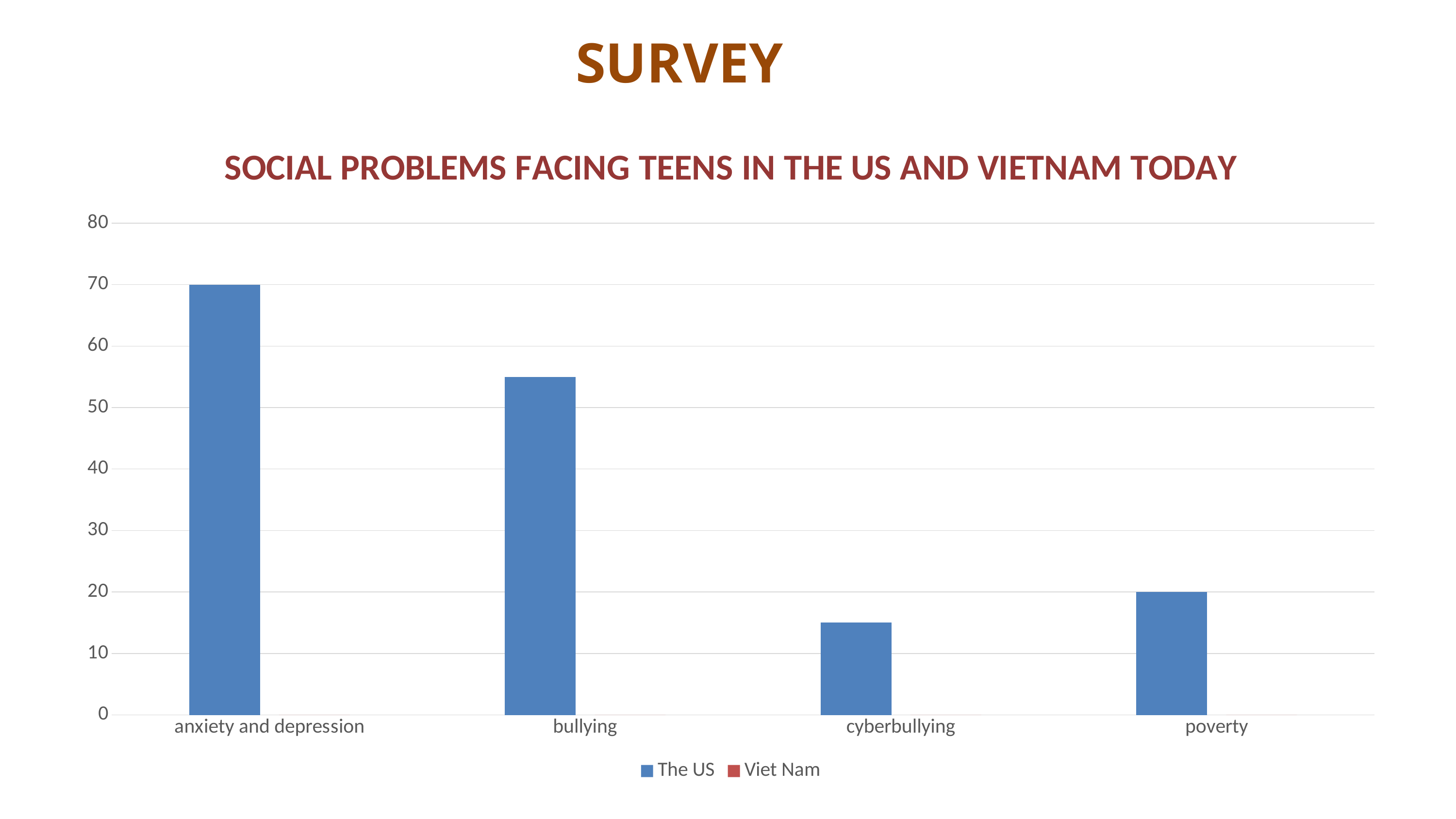
What is the difference between the values for anxiety and depression and poverty for The US? 50 Which is larger for The US, bullying or poverty? bullying How many series does the legend list? 2 Is the value for cyberbullying for The US greater or less than 20? less How many categories are shown on the x axis? 4 Which category has the highest value for The US? anxiety and depression What is the title of the chart? SOCIAL PROBLEMS FACING TEENS IN THE US AND VIETNAM TODAY What is the value for poverty for The US? 20 What is the value for anxiety and depression for The US? 70 Is the value for bullying for The US greater or less than 50? greater Which category has the lowest value for The US? cyberbullying What type of chart is shown on the slide? bar chart